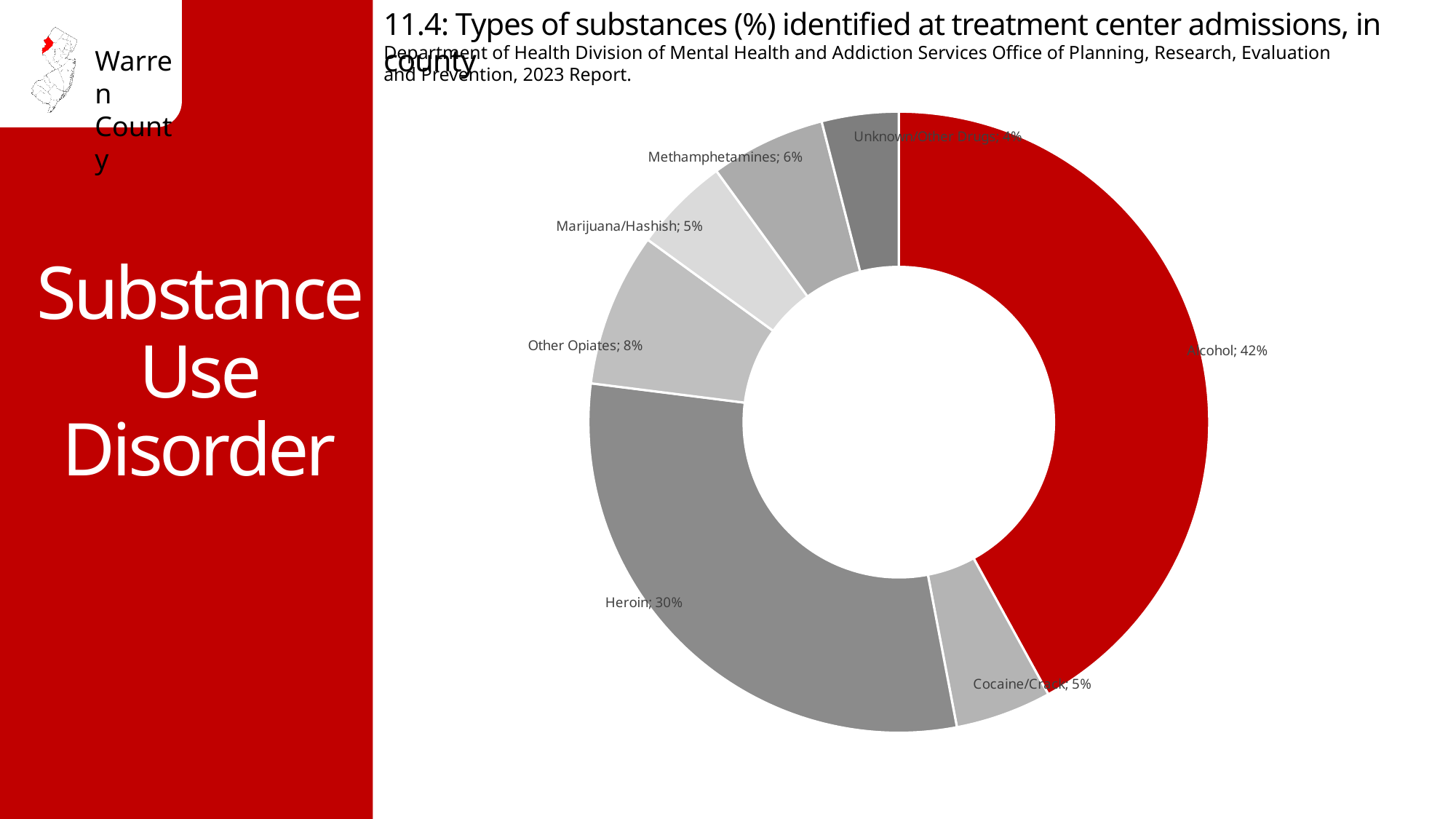
Which slice of the chart is coloured red? Alcohol What is the value for Unknown/Other Drugs? 4% Which substance has the smallest share of admissions? Unknown/Other Drugs What percentage is shown for Methamphetamines? 6% What is the difference in percentage points between Alcohol and Heroin? 12 Which is larger, the share for Other Opiates or the share for Methamphetamines? Other Opiates Which substance has the largest share of admissions? Alcohol How many substance categories are shown in the chart? 7 What percentage of treatment center admissions is identified as Alcohol? 42% What kind of chart is used on this slide? Doughnut chart What percentage is shown for Heroin? 30% What is the value for Other Opiates? 8%